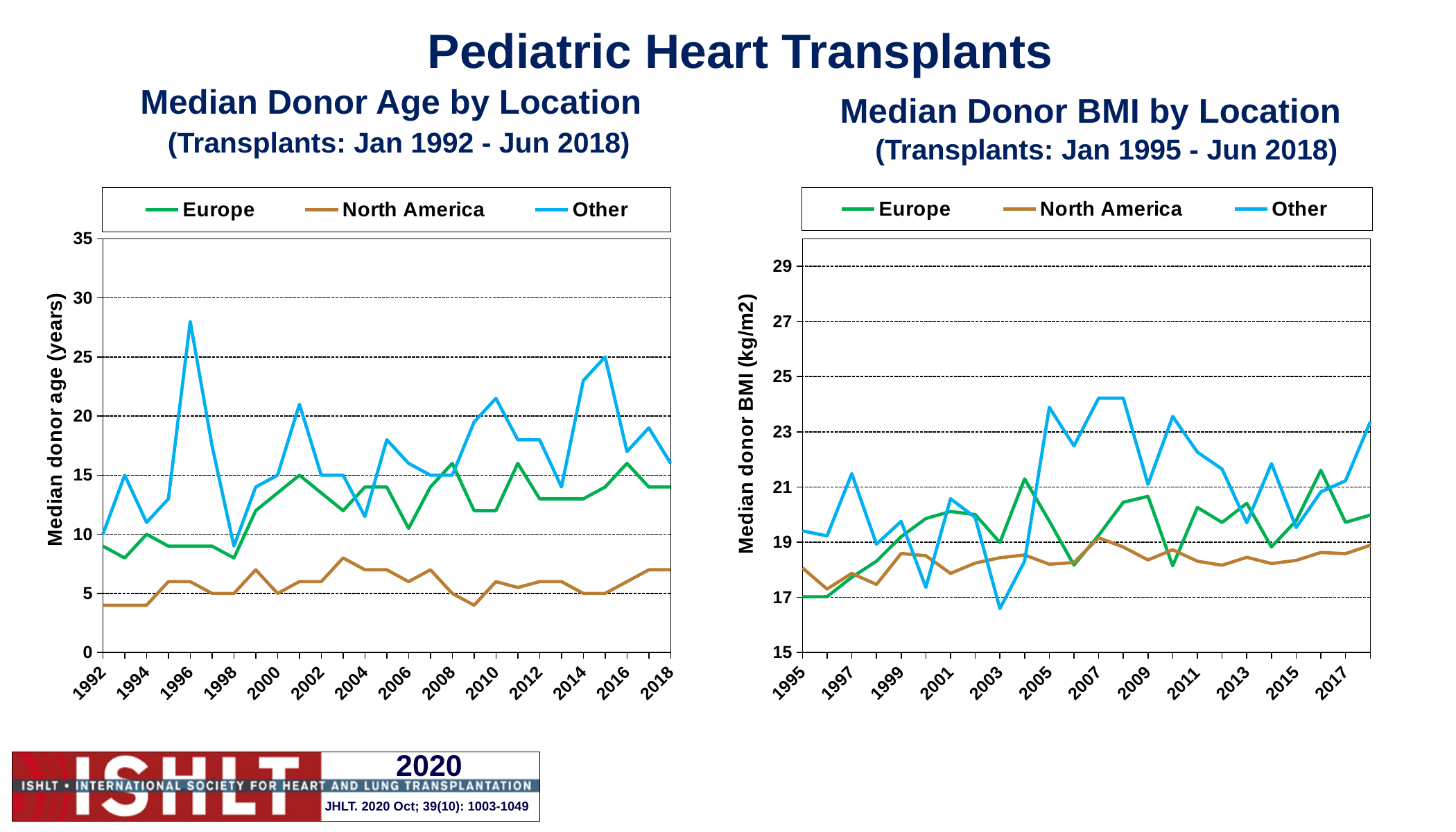
In the Median Donor Age by Location chart, which is larger in 2016, Europe or North America? Europe In the Median Donor Age by Location chart, is the value for Other in 1996 greater or less than 25? greater What type of chart is the Median Donor Age by Location chart? line chart In the Median Donor Age by Location chart, which series has the lowest values across the whole period? North America How many series does the legend of the Median Donor BMI by Location chart list? 3 In the Median Donor BMI by Location chart, which is larger in 2005, Other or Europe? Other What is the y-axis label of the Median Donor BMI by Location chart? Median donor BMI (kg/m2) In the Median Donor Age by Location chart, is the value for North America in 2009 greater or less than 5? less In the Median Donor Age by Location chart, in which year does the Other series reach its highest value? 1996 In the Median Donor Age by Location chart, what is the median donor age for Other in 2015? 25 In the Median Donor Age by Location chart, what is the median donor age for Europe in 1994? 10 In the Median Donor BMI by Location chart, is the value for Other in 2003 greater or less than 17? less